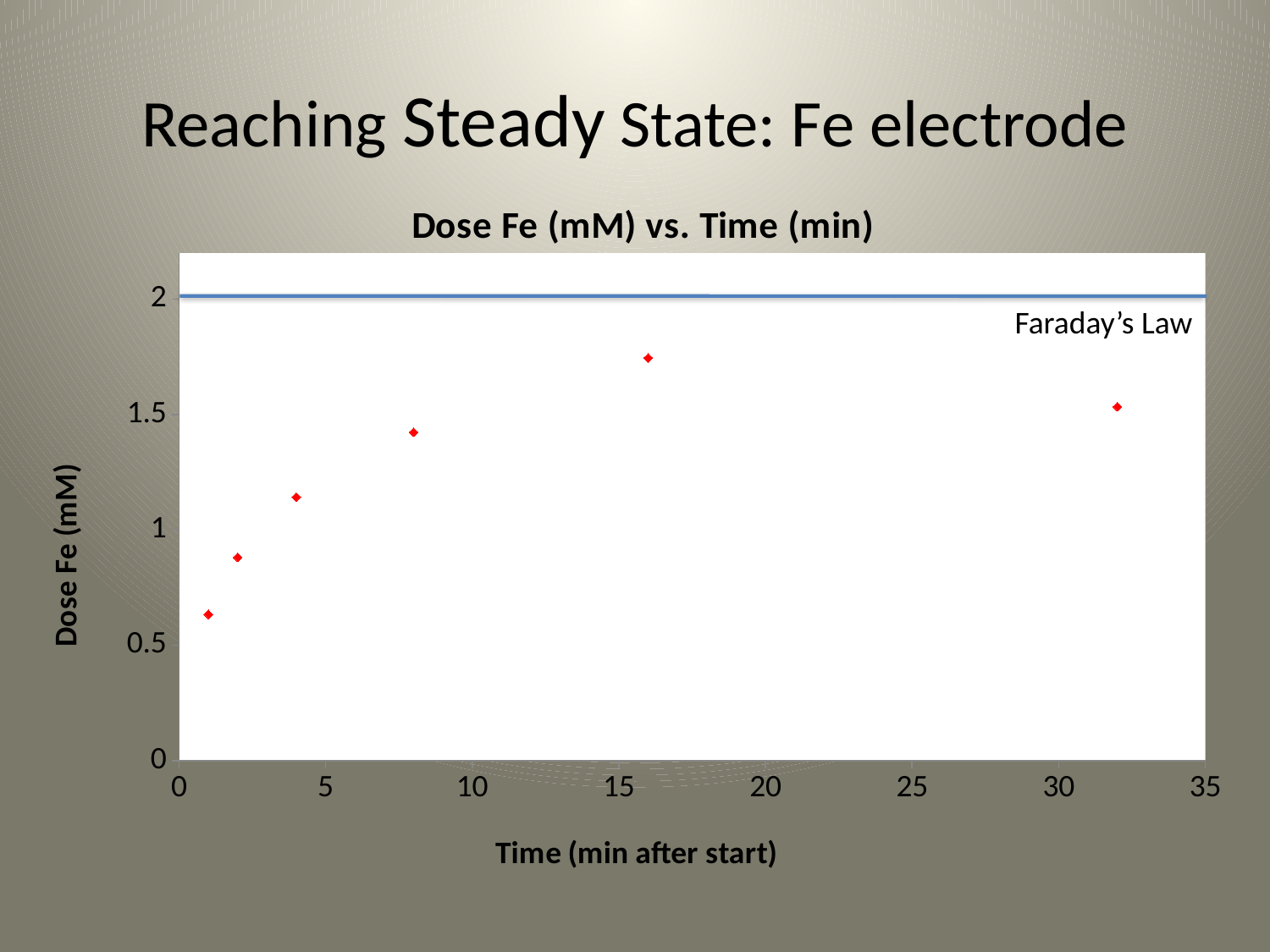
At which time (min after start) is the plotted Dose Fe value lowest? 1 At which time (min after start) is the plotted Dose Fe value highest? 16 Is the Dose Fe value at time 8 min greater or less than 1? greater What kind of chart is shown on the slide? scatter chart Is the Dose Fe value at time 1 min greater or less than 1? less How many red data points are plotted on the chart? 6 Do the plotted Dose Fe values rise or fall between time 1 min and time 16 min? rise What label is given to the horizontal blue line on the chart? Faraday's Law Is the Dose Fe value at time 16 min greater or less than 1.5? greater What is the title of the chart? Dose Fe (mM) vs. Time (min) Which has the larger Dose Fe value, the point at 16 min or the point at 32 min? 16 min